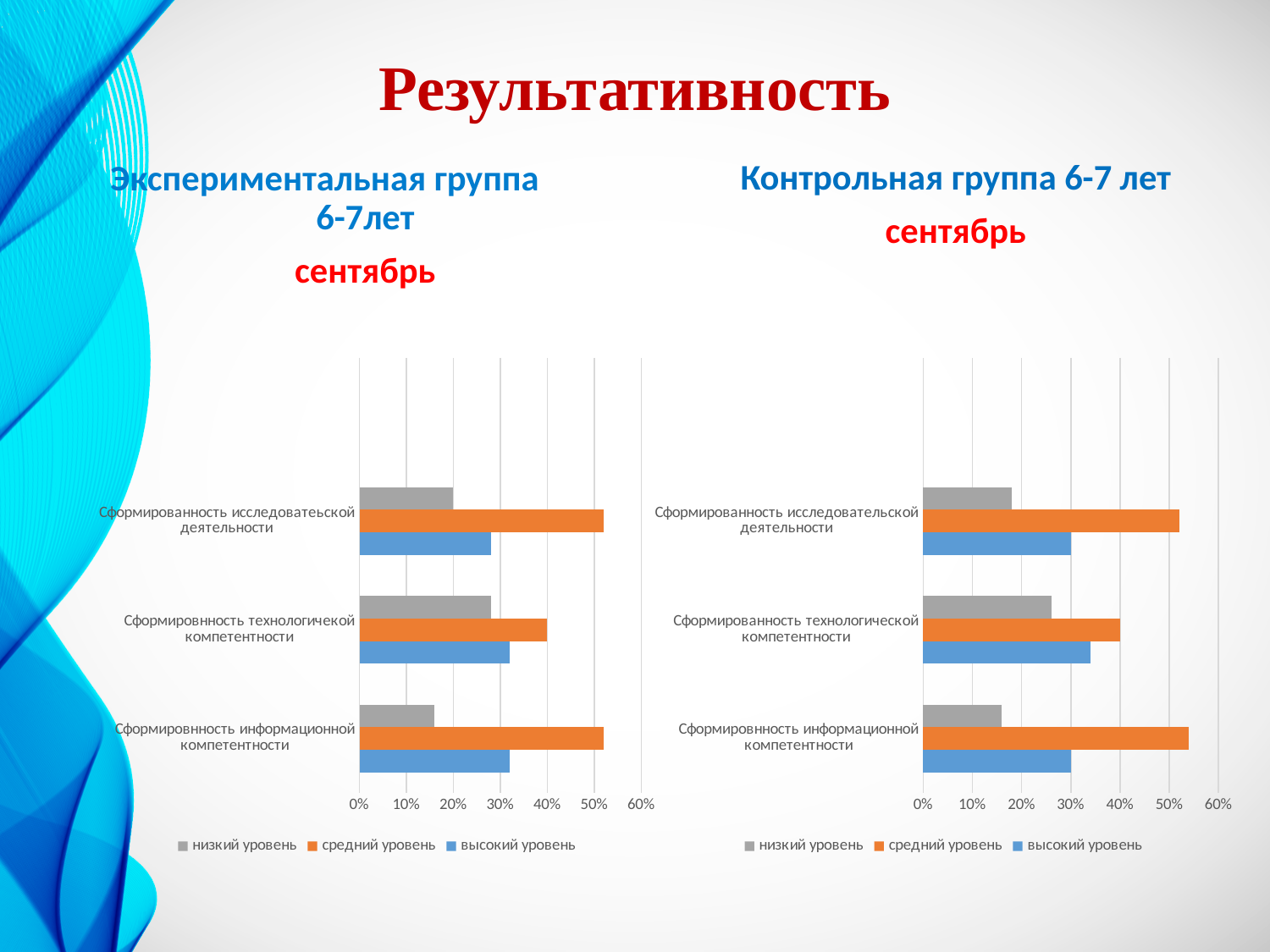
In the right chart (Контрольная группа), for Сформированность технологической компетентности, which is larger: средний уровень or низкий уровень? средний уровень In the right chart (Контрольная группа), is the value of высокий уровень for Сформированность технологической компетентности greater or less than 40%? less In the left chart (Экспериментальная группа), is the value of средний уровень for Сформированность исследоватеьской деятельности greater or less than 40%? greater In the right chart (Контрольная группа), is the value of средний уровень for Сформировнность информационной компетентности greater or less than 50%? greater In the left chart (Экспериментальная группа), for Сформированность исследоватеьской деятельности, which is larger: низкий уровень or высокий уровень? высокий уровень What colour represents средний уровень in the legend of the right chart (Контрольная группа)? orange How many series does the legend of the right chart (Контрольная группа 6-7 лет, сентябрь) list? 3 In the right chart (Контрольная группа), which level has the lowest value for Сформировнность информационной компетентности? низкий уровень How many categories are shown on the left chart (Экспериментальная группа 6-7лет)? 3 In the left chart (Экспериментальная группа), which level has the highest value for Сформировнность технологичекой компетентности? средний уровень What kind of chart is the left chart (Экспериментальная группа 6-7лет, сентябрь)? bar chart